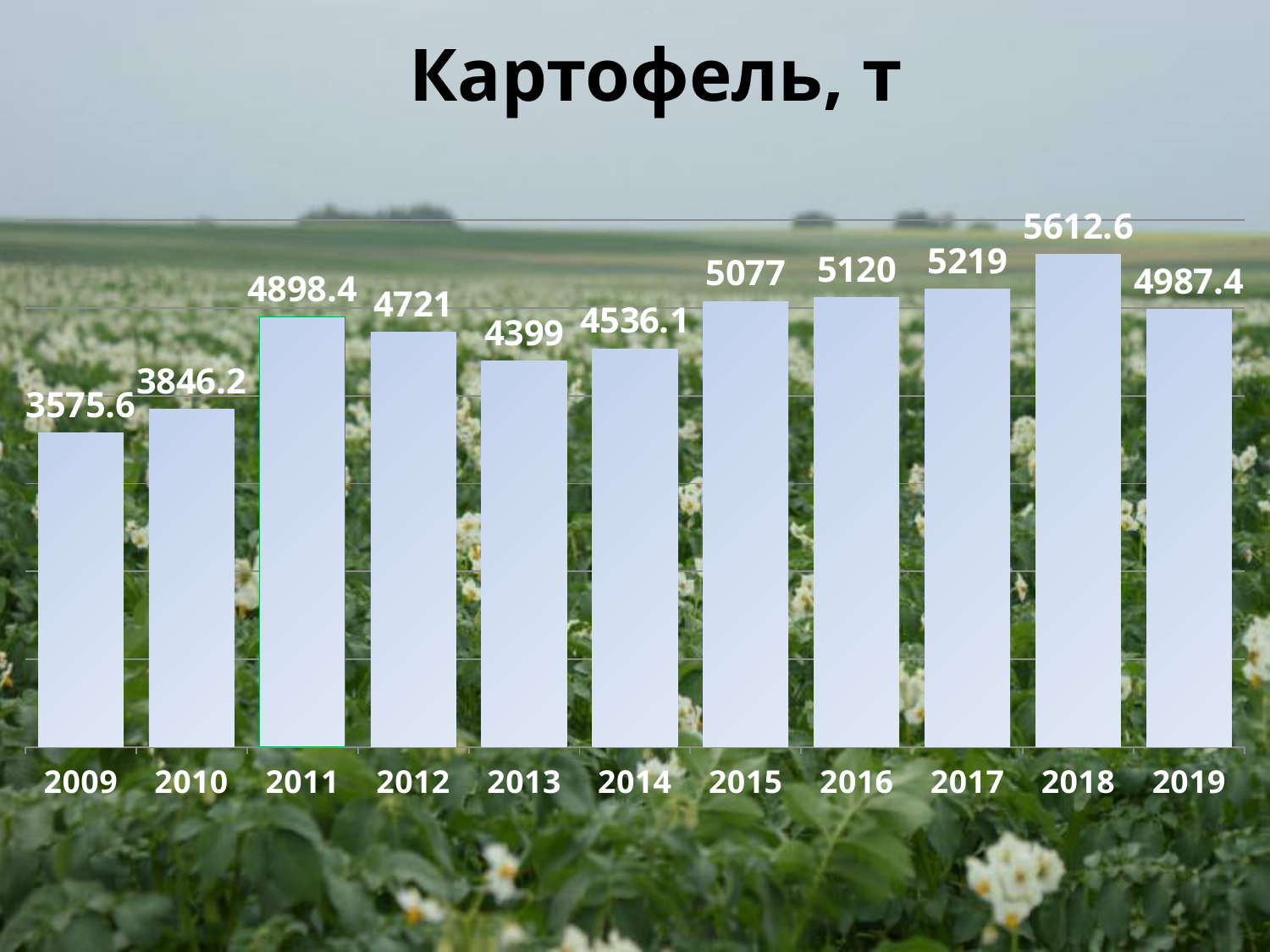
Which year has the lowest value? 2009 Which year has the highest value? 2018 Which is larger, the value for 2012 or the value for 2013? 2012 What is the value for 2009? 3575.6 What is the difference between the values for 2018 and 2009? 2037 How many years are shown on the chart? 11 What kind of chart is shown on the slide? Bar chart What is the value for 2014? 4536.1 What is the value for 2019? 4987.4 Which is larger, the value for 2015 or the value for 2019? 2015 What is the title of the chart? Картофель, т What is the difference between the values for 2011 and 2010? 1052.2